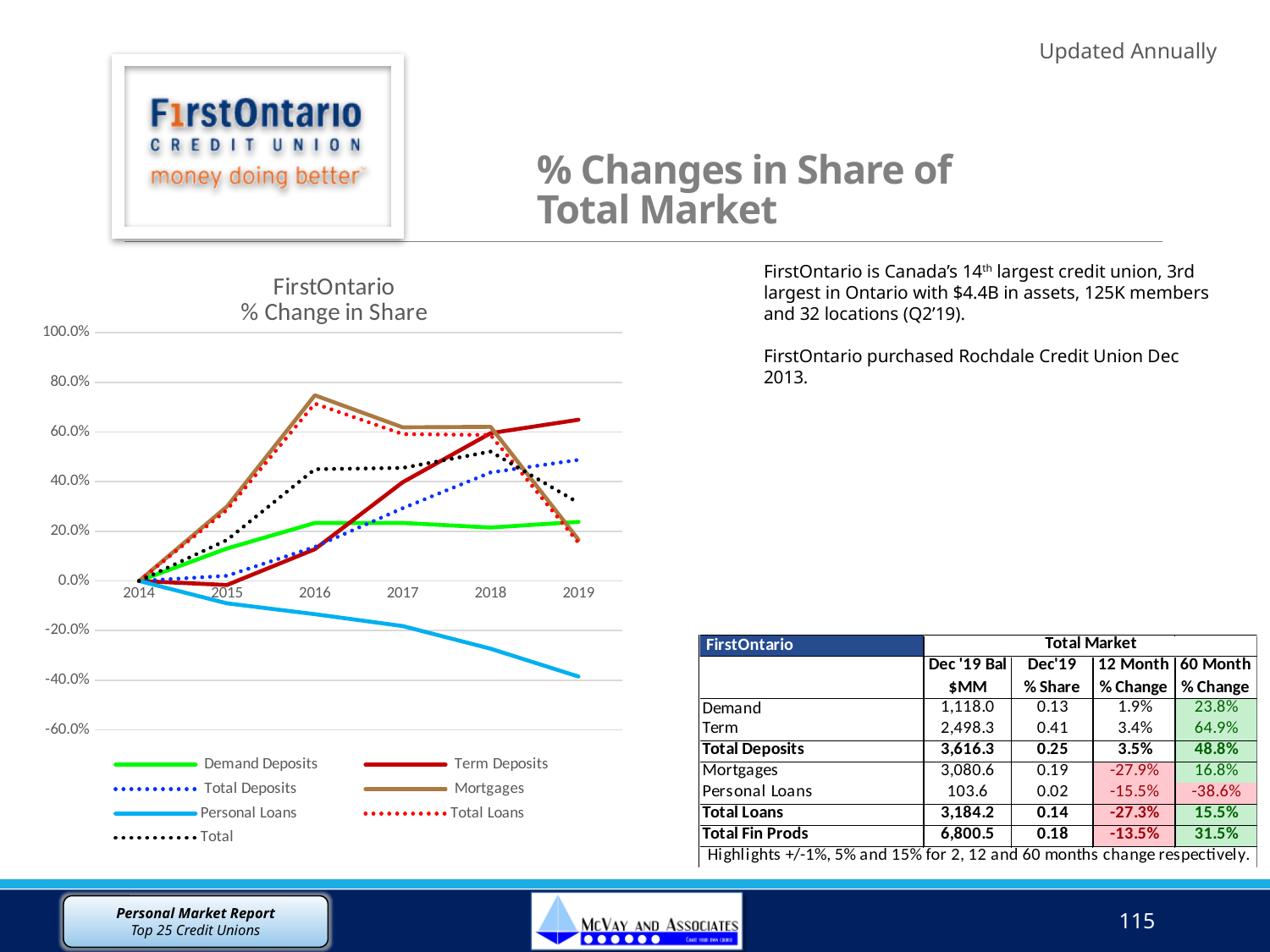
Is the value for Mortgages in 2016 greater or less than 60.0%? greater In 2016, which is larger: Mortgages or Demand Deposits? Mortgages What is the title of the chart? FirstOntario % Change in Share Which series reaches the highest point anywhere on the chart? Mortgages Is the value for Total Deposits in 2019 greater or less than 40.0%? greater Which series has the highest value in 2019? Term Deposits How many years are shown on the x axis of the chart? 6 How many series does the chart legend list? 7 Does the Personal Loans line rise or fall from 2014 to 2019? fall What kind of chart is shown on the slide? line chart Is the value for Personal Loans in 2019 greater or less than -20.0%? less Which series has the lowest value in 2019? Personal Loans